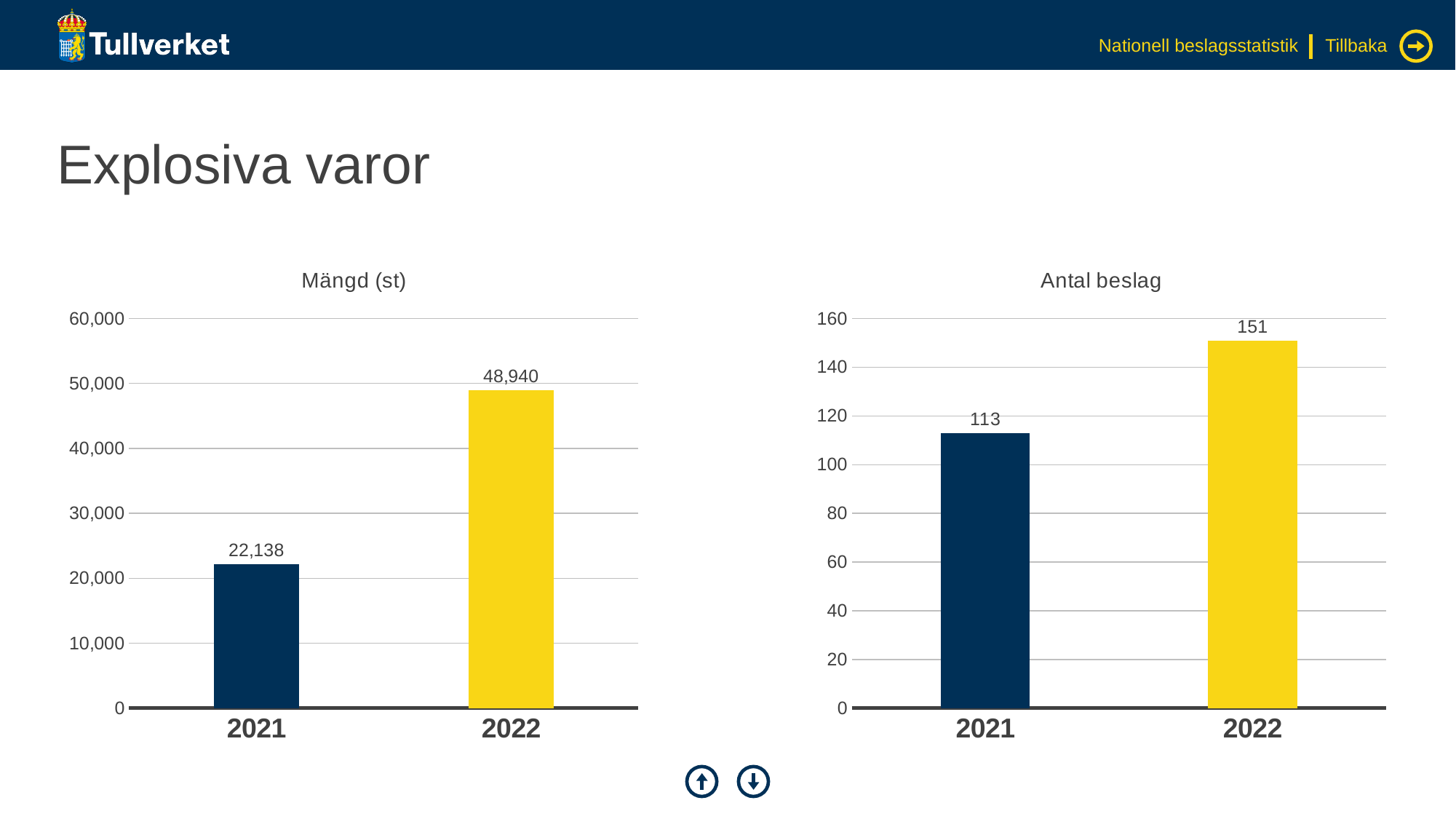
In the 'Antal beslag' chart, which year has the lowest value? 2021 In the 'Mängd (st)' chart, what is the value for 2022? 48,940 In the 'Antal beslag' chart, what is the value for 2022? 151 In the 'Antal beslag' chart, what is the value for 2021? 113 How many categories are shown on the x axis of the 'Mängd (st)' chart? 2 In the 'Antal beslag' chart, is the value for 2021 greater or less than 100? greater In the 'Mängd (st)' chart, what is the difference between the 2022 and 2021 values? 26,802 In the 'Antal beslag' chart, what is the difference between the 2022 and 2021 values? 38 In the 'Mängd (st)' chart, which year has the highest value? 2022 What kind of chart is the 'Antal beslag' chart? bar chart In the 'Mängd (st)' chart, do the values rise or fall from 2021 to 2022? rise In the 'Mängd (st)' chart, what is the value for 2021? 22,138